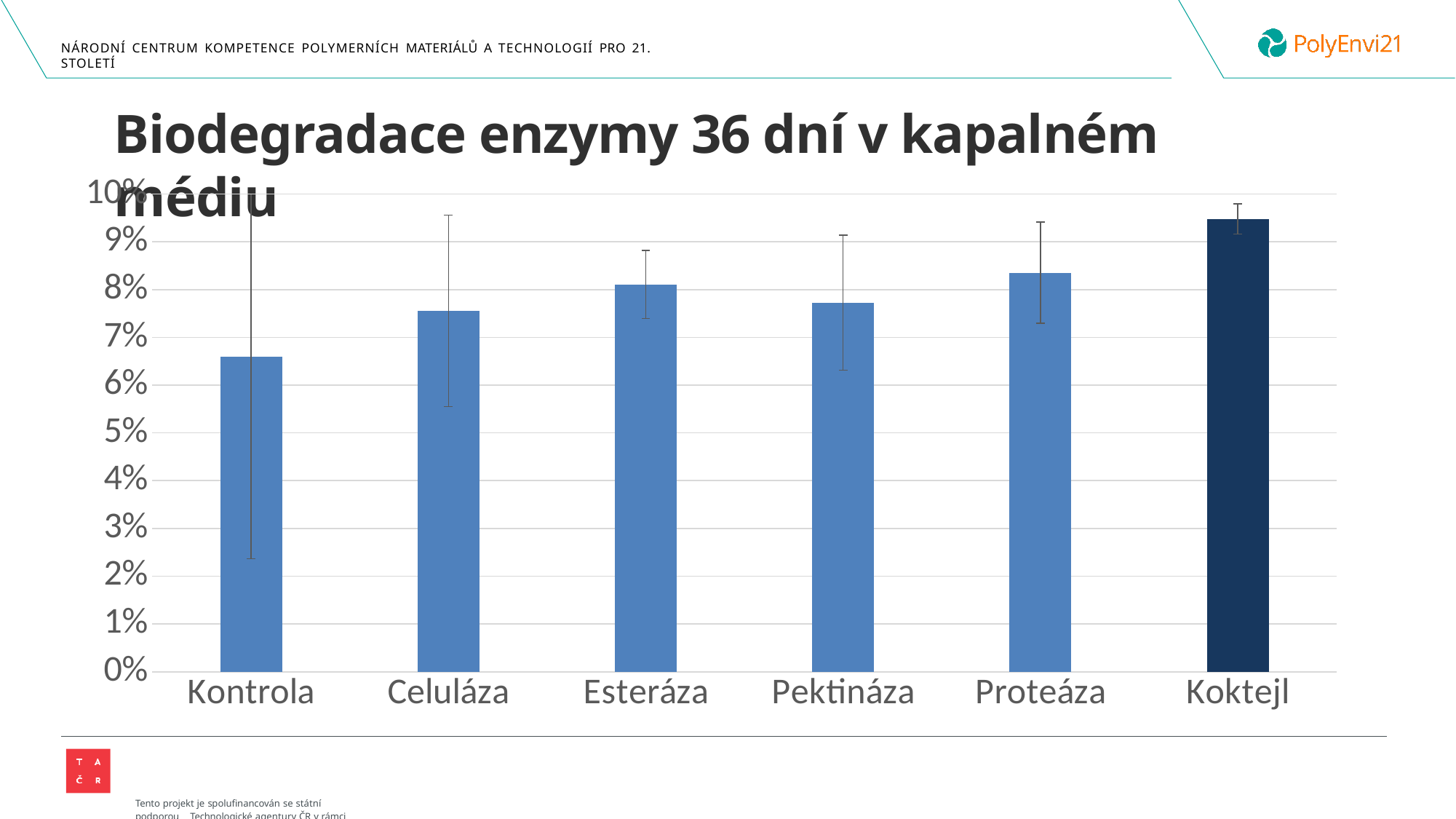
Is the value for Kontrola greater or less than 7%? less What is the title of the slide above the chart? Biodegradace enzymy 36 dní v kapalném médiu What kind of chart is shown on the slide? bar chart Which is larger, the value for Koktejl or the value for Kontrola? Koktejl Which category's bar is drawn in a darker colour than the others? Koktejl How many categories are plotted on the x axis? 6 Which category has the highest value? Koktejl Is the value for Pektináza greater or less than 8%? less Which category has the lowest value? Kontrola Which is larger, the value for Proteáza or the value for Celuláza? Proteáza Is the value for Koktejl greater or less than 9%? greater